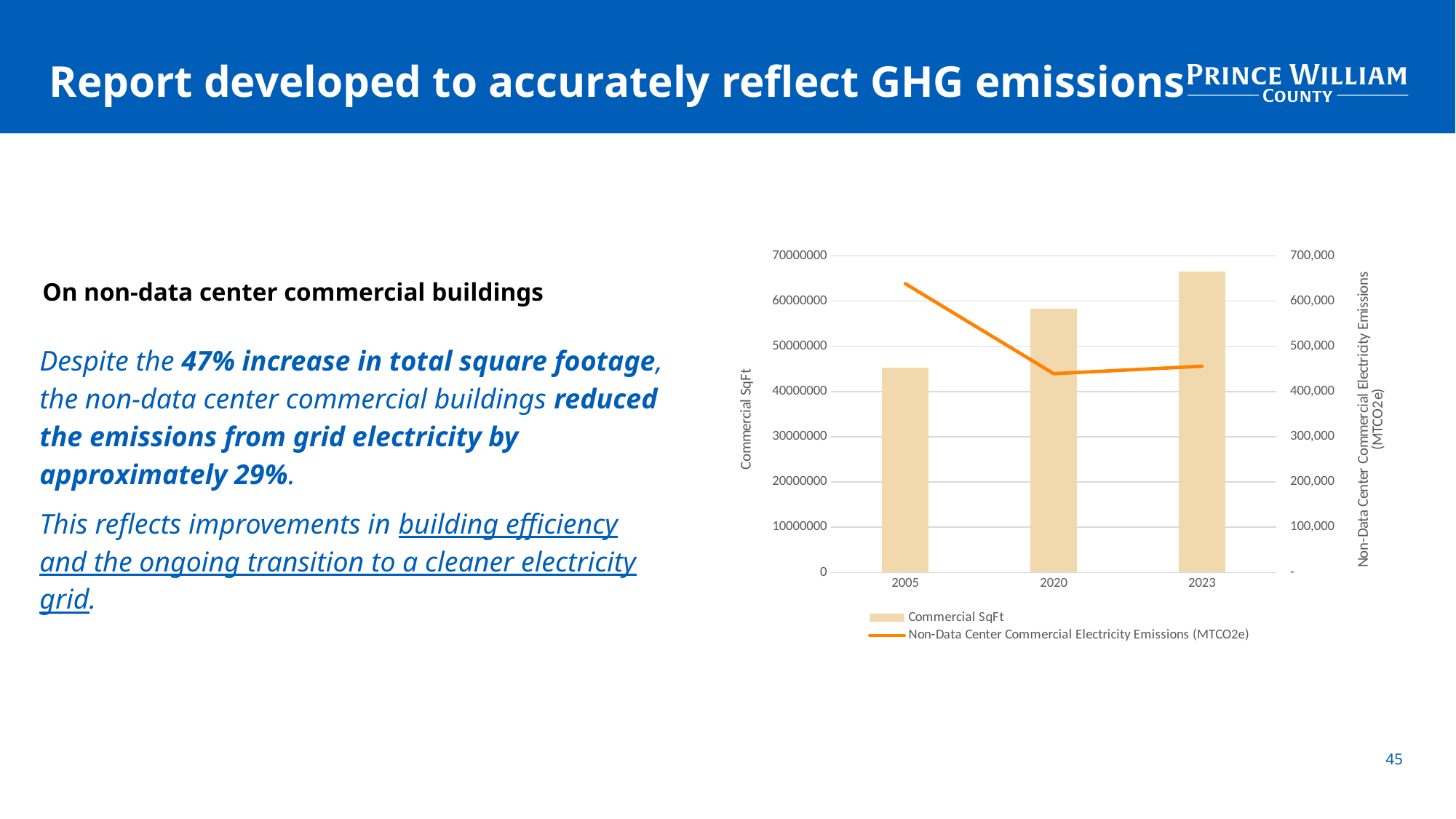
Is the Non-Data Center Commercial Electricity Emissions value for 2020 greater or less than 500,000? less Is the Commercial SqFt value for 2005 greater or less than 40000000? greater Which year has the lowest Commercial SqFt bar? 2005 Is the Commercial SqFt value for 2023 greater or less than 60000000? greater Which year has a larger Commercial SqFt value, 2005 or 2020? 2020 What kind of chart is shown on the slide? A combined bar and line chart Does the Commercial SqFt series rise or fall from 2005 to 2023? Rises Which year has the highest Commercial SqFt bar? 2023 In which year is the Non-Data Center Commercial Electricity Emissions line at its highest? 2005 How many years are shown on the x axis of the chart? 3 How many series does the chart legend list? 2